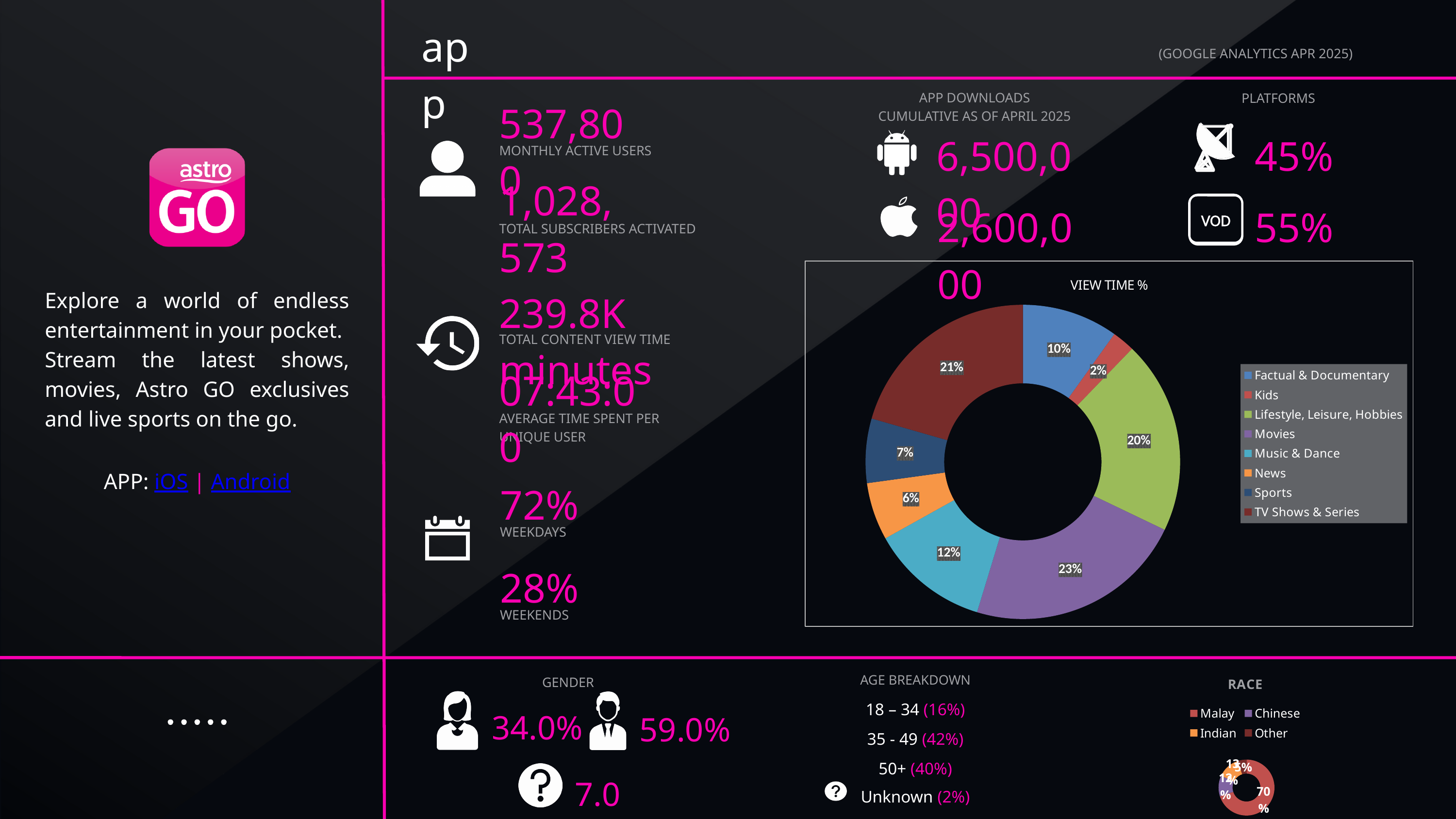
What type of chart is the VIEW TIME % chart? Donut (pie) chart In the VIEW TIME % chart, which category has the smallest share? Kids In the VIEW TIME % chart, which is larger: Sports or Factual & Documentary? Factual & Documentary How many categories does the legend of the VIEW TIME % chart list? 8 In the VIEW TIME % chart, what colour represents Movies? Purple In the VIEW TIME % chart, what percentage is shown for Movies? 23% In the VIEW TIME % chart, which category has the largest share? Movies In the VIEW TIME % chart, what is the difference between the Lifestyle, Leisure, Hobbies share and the News share? 14% In the VIEW TIME % chart, what percentage is shown for Music & Dance? 12% How many categories does the legend of the RACE chart list? 4 In the VIEW TIME % chart, what percentage is shown for Kids? 2% In the VIEW TIME % chart, what percentage is shown for TV Shows & Series? 21%